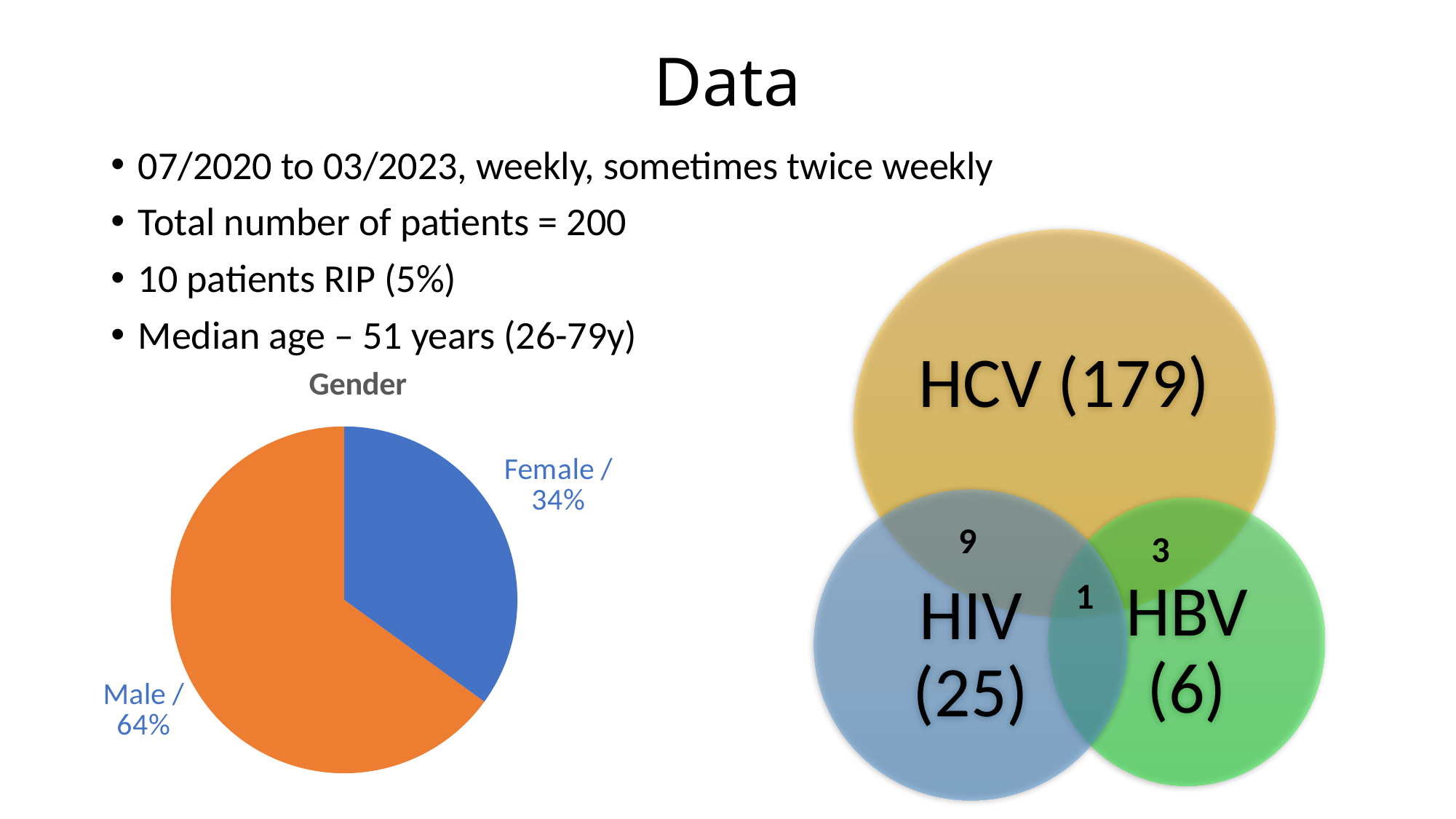
In the Gender pie chart, by how many percentage points does the Male share exceed the Female share? 30 percentage points In the Gender pie chart, what percentage is Male? 64% In the Gender pie chart, which is larger, the Male share or the Female share? Male What kind of chart is the Gender chart? pie chart In the Gender pie chart, what percentage is Female? 34% What is the title of the pie chart on the left? Gender In the Venn diagram on the right, how many patients are in the HCV circle? 179 In the Gender pie chart, what colour is the Male slice? orange How many slices does the Gender pie chart have? 2 In the Gender pie chart, which category has the largest share? Male In the Gender pie chart, which category has the smallest share? Female In the Venn diagram on the right, how many patients are in the overlap between HCV and HIV? 9